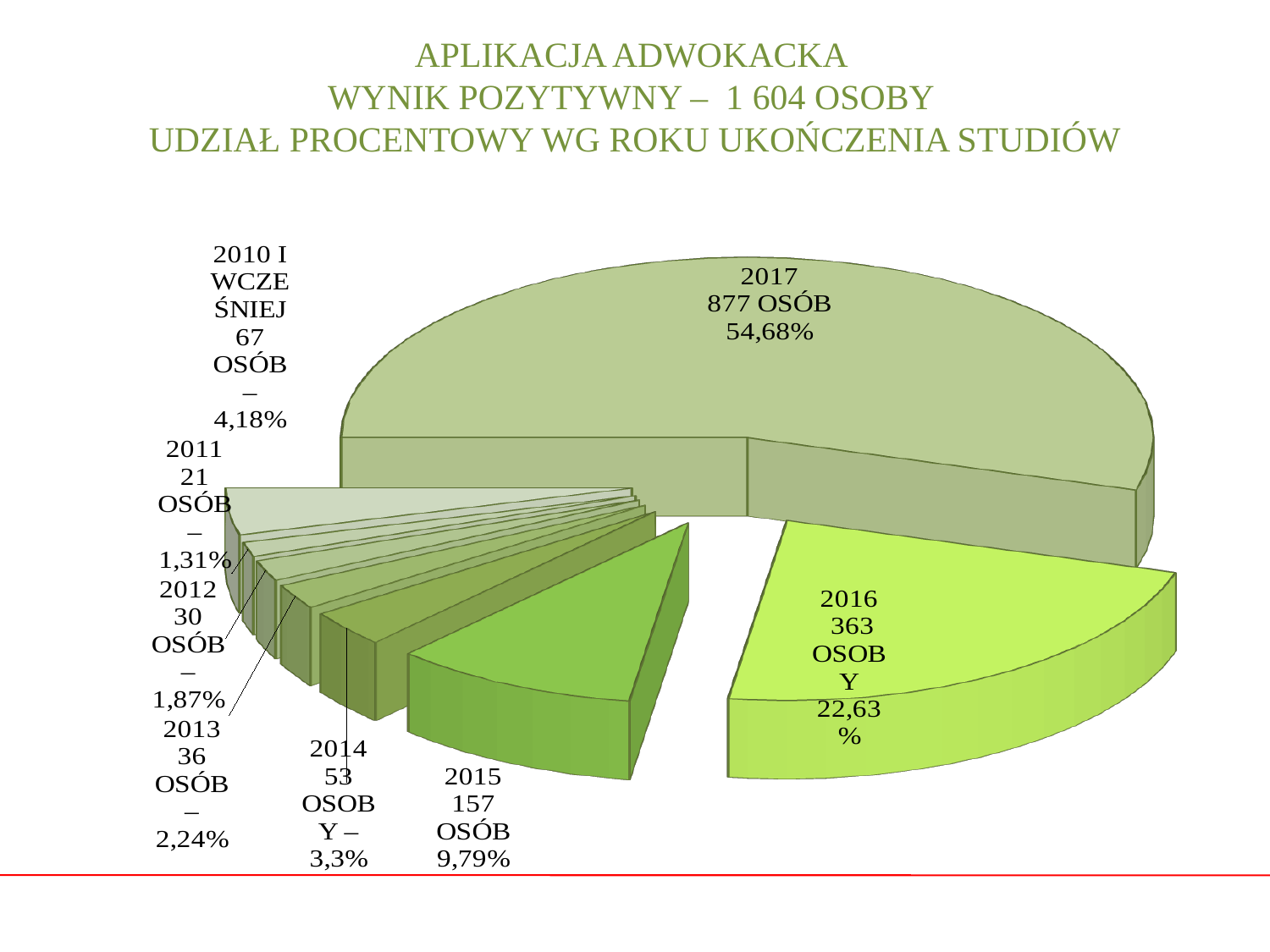
Which year has the smallest slice of the pie? 2011 Which year has the largest slice of the pie? 2017 How many people are in the 2014 slice? 53 What kind of chart is shown on the slide? pie chart According to the title, how many people in total achieved a positive result? 1 604 How many people (osób) are in the 2017 slice? 877 What percentage share does the 2016 slice have? 22,63% What percentage share does the 2015 slice have? 9,79% What is the difference in number of people between the 2017 and 2016 slices? 514 Which slice is larger, 2013 or 2012? 2013 How many slices does the pie chart have? 8 What percentage share does the '2010 i wcześniej' slice have? 4,18%